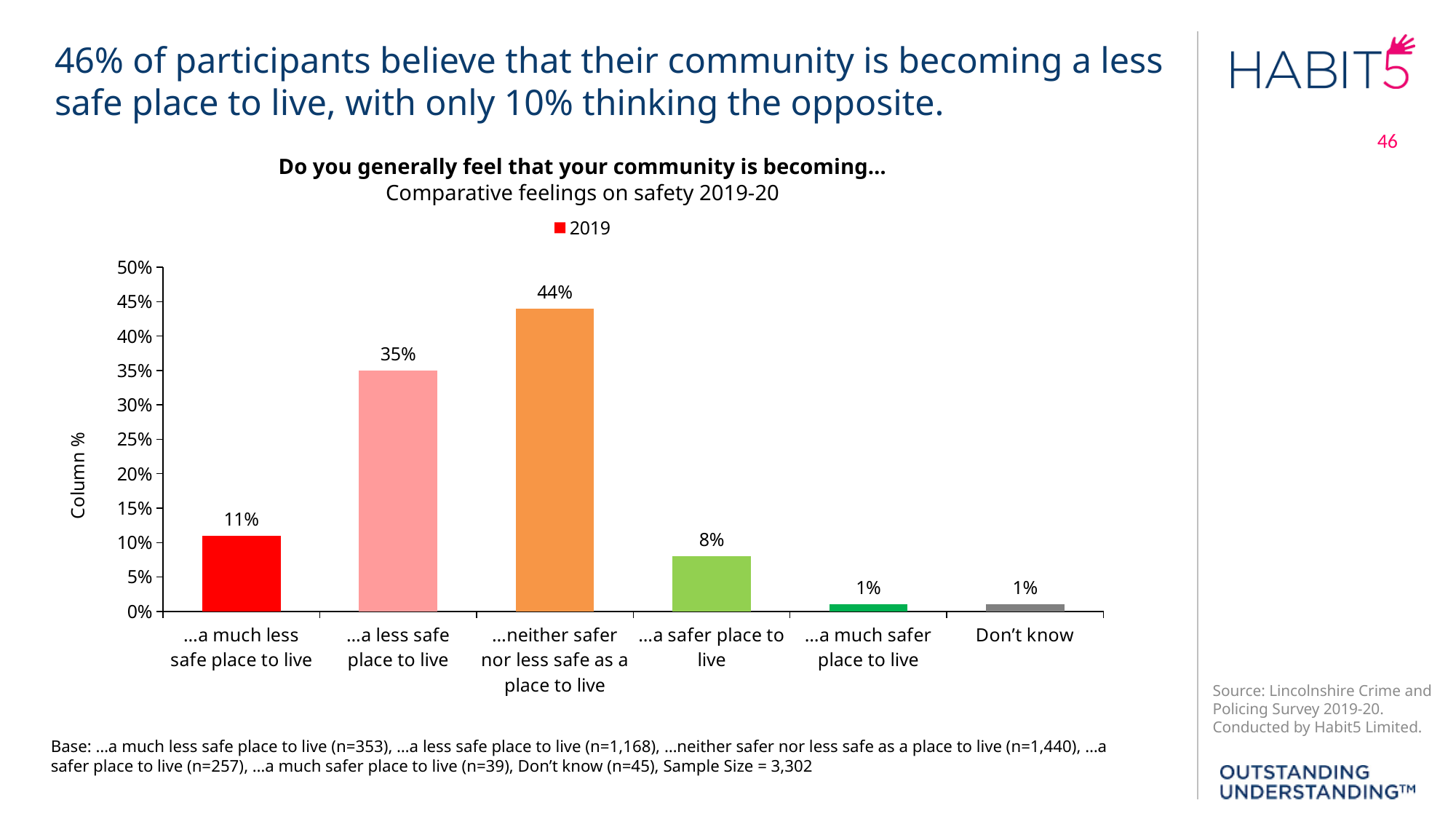
Which category has the highest value? ...neither safer nor less safe as a place to live Is the value for '...neither safer nor less safe as a place to live' greater or less than 40%? greater What percentage answered 'Don't know'? 1% What is the label on the y axis? Column % What kind of chart is shown? bar chart How many series does the legend list? 1 What is the difference between '...a less safe place to live' and '...a safer place to live'? 27% How many categories are shown on the x axis? 6 What is the value for '...neither safer nor less safe as a place to live'? 44% What series name appears in the legend? 2019 Which is larger: '...a much less safe place to live' or '...a safer place to live'? ...a much less safe place to live